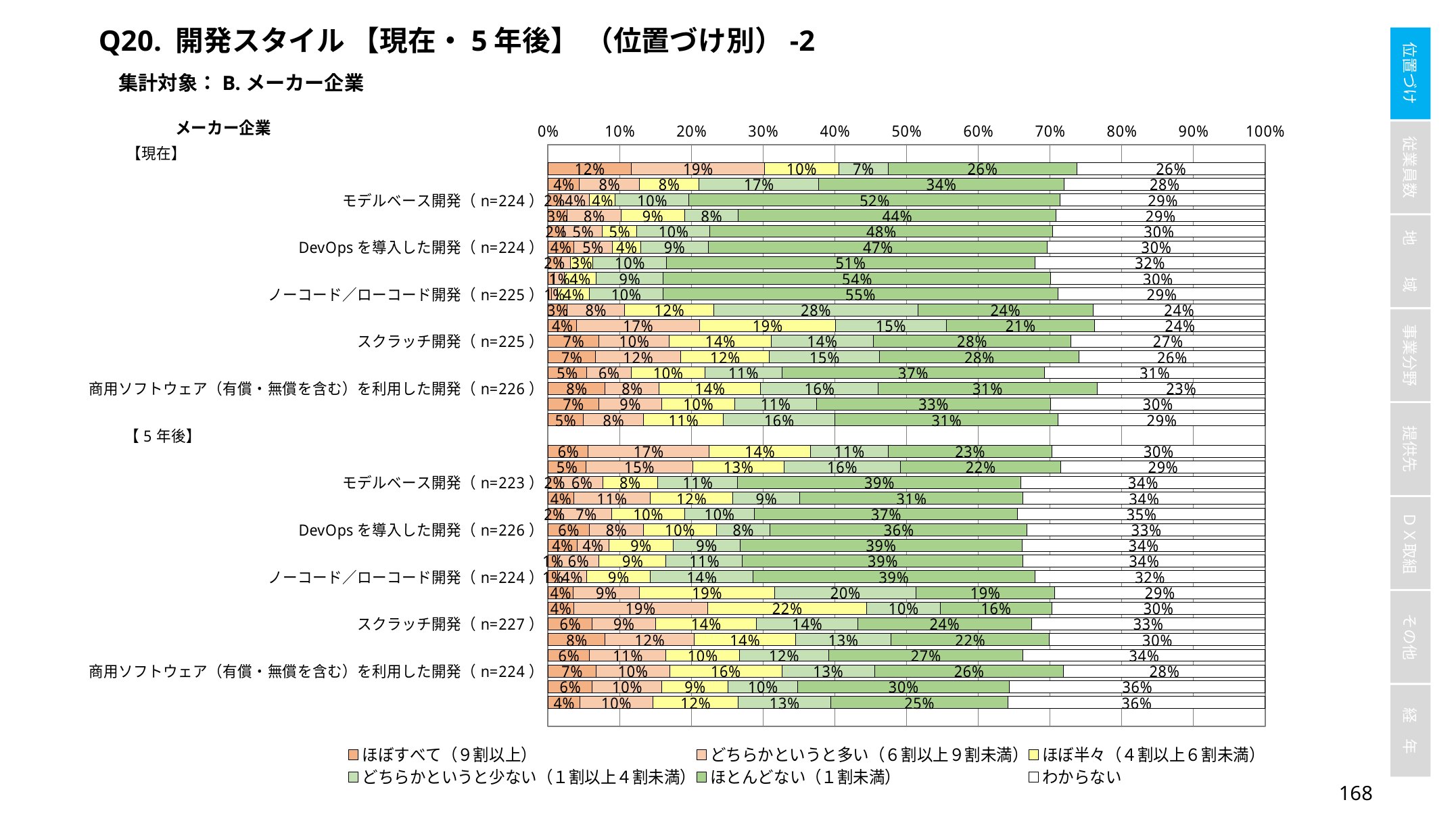
In the 【5年後】 section, in the bar aligned with the label スクラッチ開発（n=227）, which segment is larger: わからない or ほとんどない（1割未満）? わからない In the 【現在】 section, in the bar aligned with the label モデルベース開発（n=224）, what is the value of the ほとんどない（1割未満） segment? 52% For the bars aligned with the モデルベース開発 labels, what is the difference between the ほとんどない（1割未満） value in 【現在】 (52%) and in 【5年後】 (39%)? 13 percentage points In the 【5年後】 section, in the bar aligned with the label DevOpsを導入した開発（n=226）, what is the value of the ほぼすべて（9割以上） segment? 6% How many series does the legend list for the chart? 6 What is the maximum value shown on the horizontal axis of the chart? 100% For the bars aligned with the モデルベース開発 labels, is the ほとんどない（1割未満） value larger in the 【現在】 section or the 【5年後】 section? 【現在】 In the 【5年後】 section, in the bar aligned with the label 商用ソフトウェア（有償・無償を含む）を利用した開発（n=224）, what is the value of the わからない segment? 28% What is the n value shown for スクラッチ開発 in the 【5年後】 section? 227 What kind of chart is shown on the slide? Stacked horizontal bar chart In the 【現在】 section, in the bar aligned with the label 商用ソフトウェア（有償・無償を含む）を利用した開発（n=226）, what is the value of the ほぼ半々（4割以上6割未満） segment? 14% In the 【現在】 section, in the bar aligned with the label スクラッチ開発（n=225）, what is the value of the ほとんどない（1割未満） segment? 28%